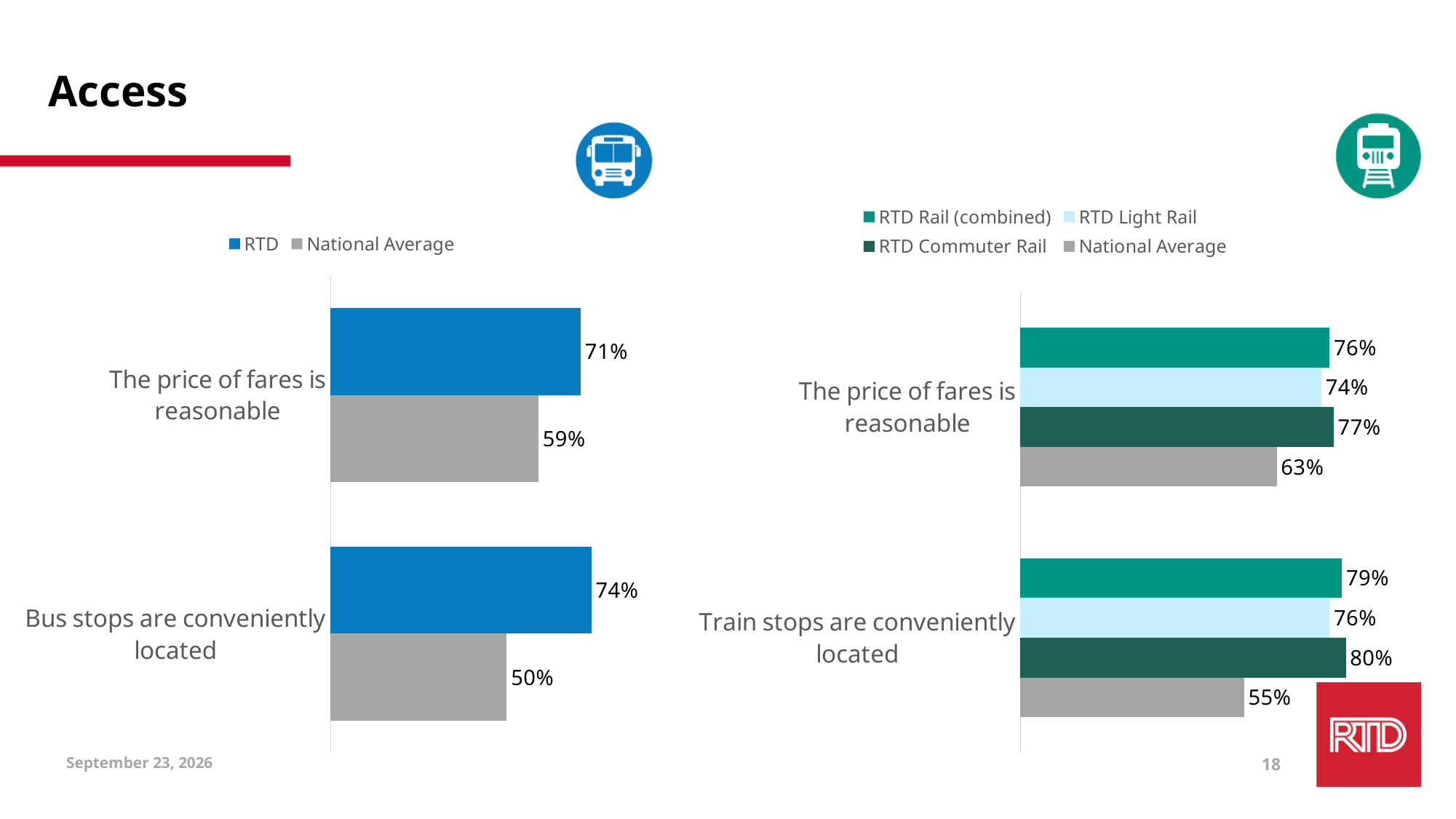
In the left (bus) chart, what is the RTD value for 'The price of fares is reasonable'? 71% In the left (bus) chart, what is the difference between the RTD and National Average values for 'Bus stops are conveniently located'? 24 percentage points In the right (rail) chart, which series has the lowest value for 'The price of fares is reasonable'? National Average In the left (bus) chart, what is the National Average value for 'Bus stops are conveniently located'? 50% In the right (rail) chart, which series has the highest value for 'Train stops are conveniently located'? RTD Commuter Rail What kind of chart is the left (bus) chart? Bar chart In the right (rail) chart, what is the RTD Light Rail value for 'The price of fares is reasonable'? 74% In the right (rail) chart, what is the RTD Commuter Rail value for 'Train stops are conveniently located'? 80% In the left (bus) chart, how many series does the legend list? 2 In the right (rail) chart, what is the difference between the RTD Rail (combined) and National Average values for 'The price of fares is reasonable'? 13 percentage points In the right (rail) chart, how many series does the legend list? 4 In the right (rail) chart, which is larger: the RTD Light Rail value for 'Train stops are conveniently located' or the National Average value for the same category? RTD Light Rail